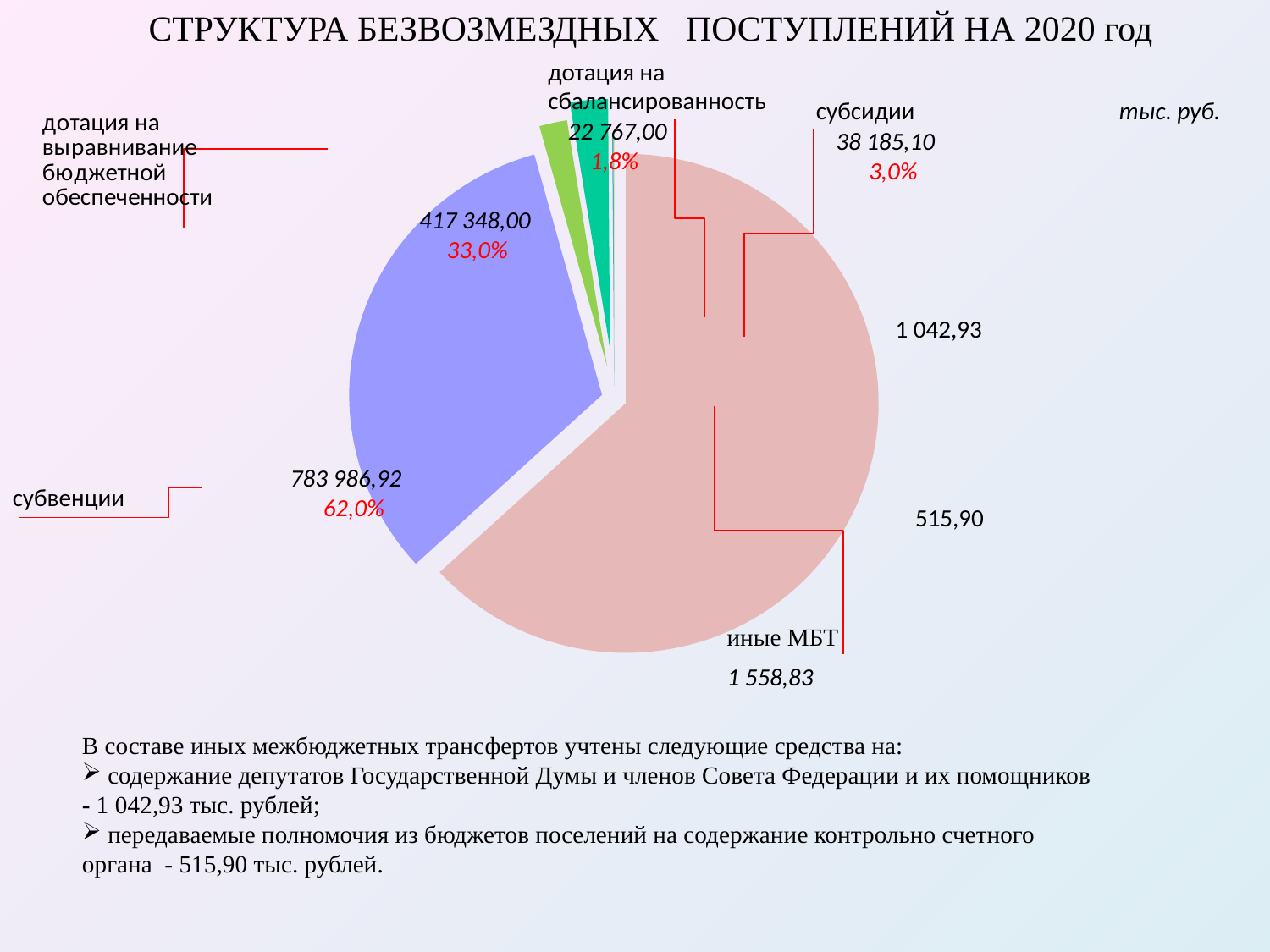
Which is larger, субсидии or дотация на сбалансированность? субсидии What share of the pie does субвенции take? 62,0% What kind of chart is shown on the slide? pie chart What is the value for дотация на выравнивание бюджетной обеспеченности? 417 348,00 Which category has the smallest value? иные МБТ What is the value for иные МБТ? 1 558,83 What share of the pie does дотация на выравнивание бюджетной обеспеченности take? 33,0% Which category has the largest slice of the pie? субвенции What is the value for дотация на сбалансированность? 22 767,00 What is the value for субвенции? 783 986,92 What is the difference between the values for субсидии and дотация на сбалансированность? 15 418,10 What is the value for субсидии? 38 185,10